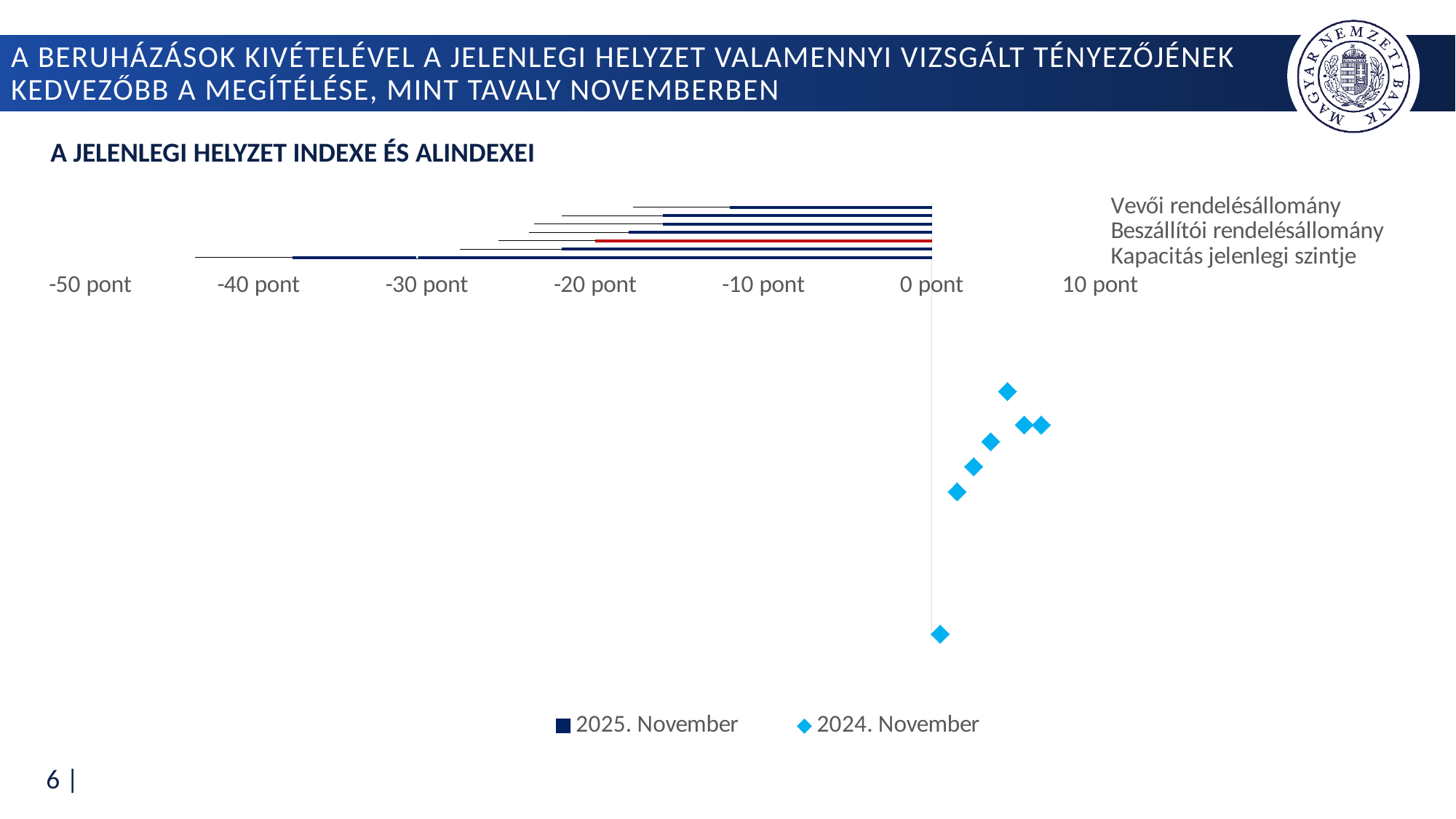
Is the value of the longest 2025. November bar greater or less than -40 pont? greater Which two series are listed in the chart legend? 2025. November and 2024. November Which series is shown with diamond markers in the legend? 2024. November What is the title of the chart? A JELENLEGI HELYZET INDEXE ÉS ALINDEXEI How many series does the chart legend list? 2